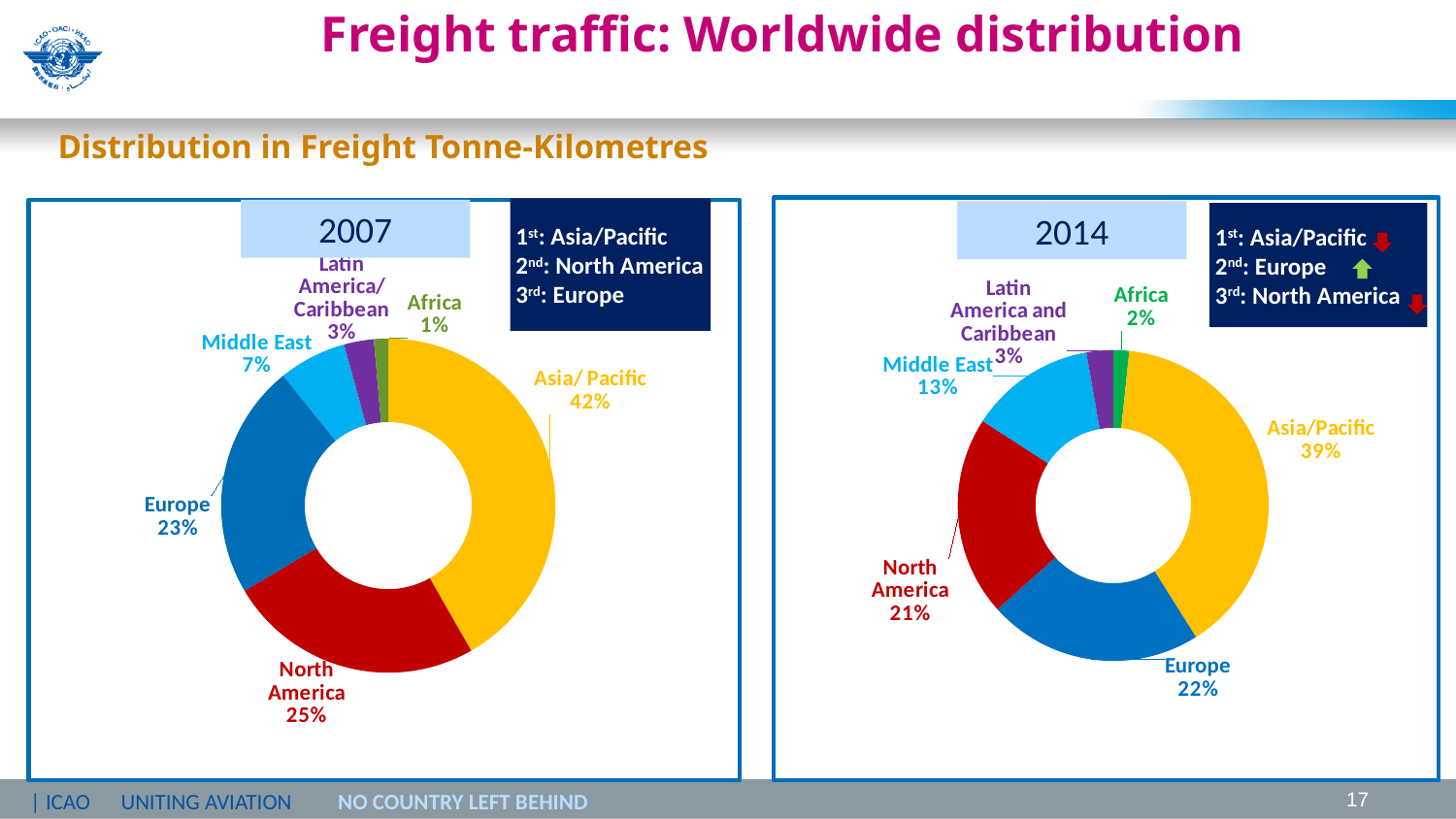
In the 2014 chart, which region has the largest share? Asia/Pacific In the 2007 chart, what colour is the Europe segment? Blue In the 2007 chart, what share does Asia/Pacific have? 42% In the 2007 chart, which region has the smallest share? Africa In the 2007 chart, which is larger: the share of the Middle East or the share of Latin America/Caribbean? Middle East In the 2014 chart, which region is ranked 2nd according to the box next to the chart? Europe In the 2014 chart, what is the difference between the shares of Asia/Pacific and North America? 18% What kind of chart is used for the 2007 distribution? Doughnut chart How many regions are shown in the 2014 chart? 6 In the 2014 chart, what share does Europe have? 22% In the 2014 chart, what share does the Middle East have? 13% In the 2007 chart, what is the difference between the shares of North America and Europe? 2%